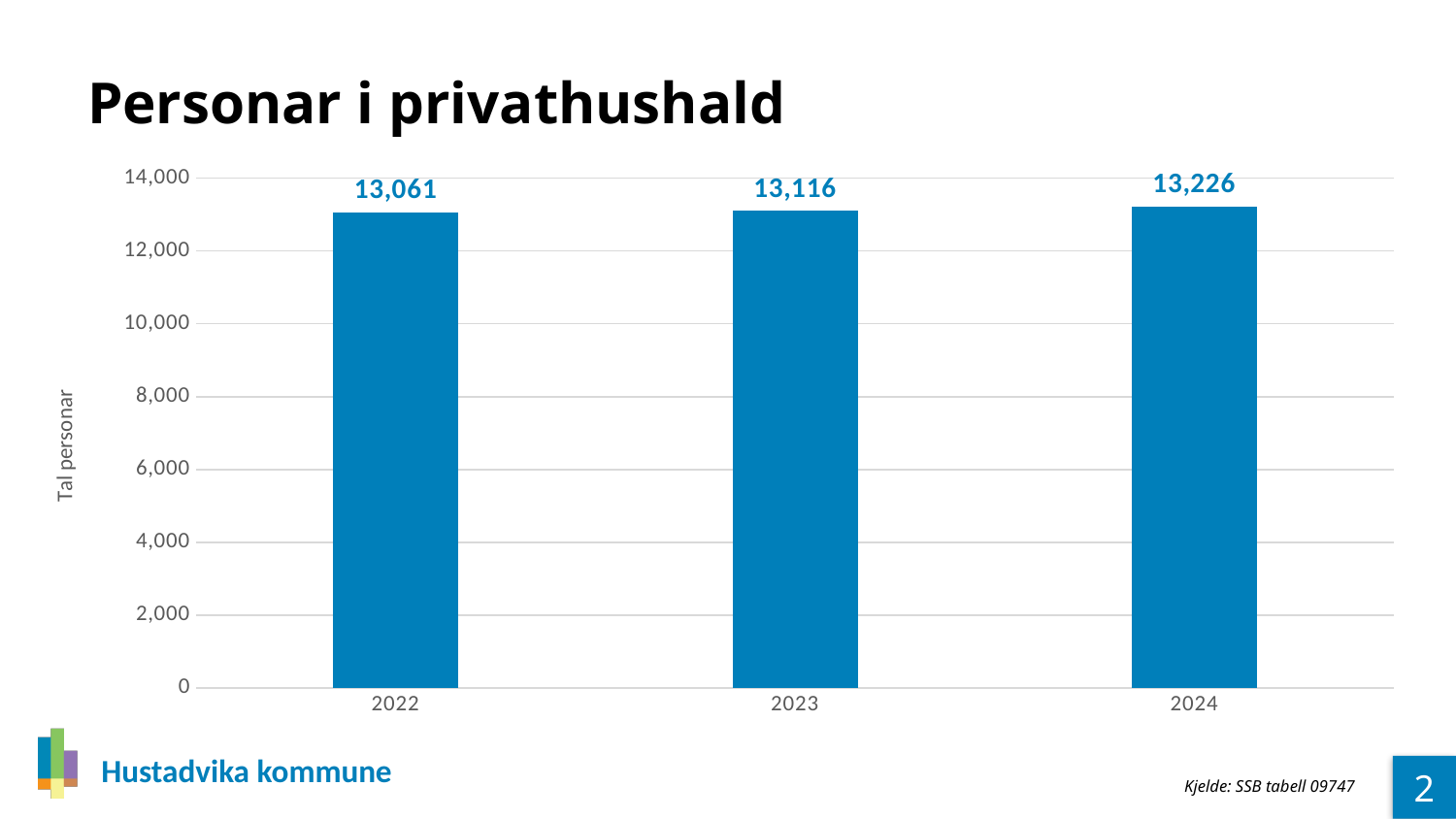
Which year has the lowest value? 2022 Which year has the highest value? 2024 Which is larger, the value for 2023 or the value for 2024? 2024 What kind of chart is shown on the slide? bar chart What is the difference between the values for 2023 and 2022? 55 Do the values rise or fall from 2022 to 2024? rise What is the value for 2022? 13,061 How many years are shown on the x axis? 3 Is the value for 2022 greater or less than 12,000? greater What is the value for 2023? 13,116 What is the difference between the values for 2024 and 2022? 165 What is the value for 2024? 13,226